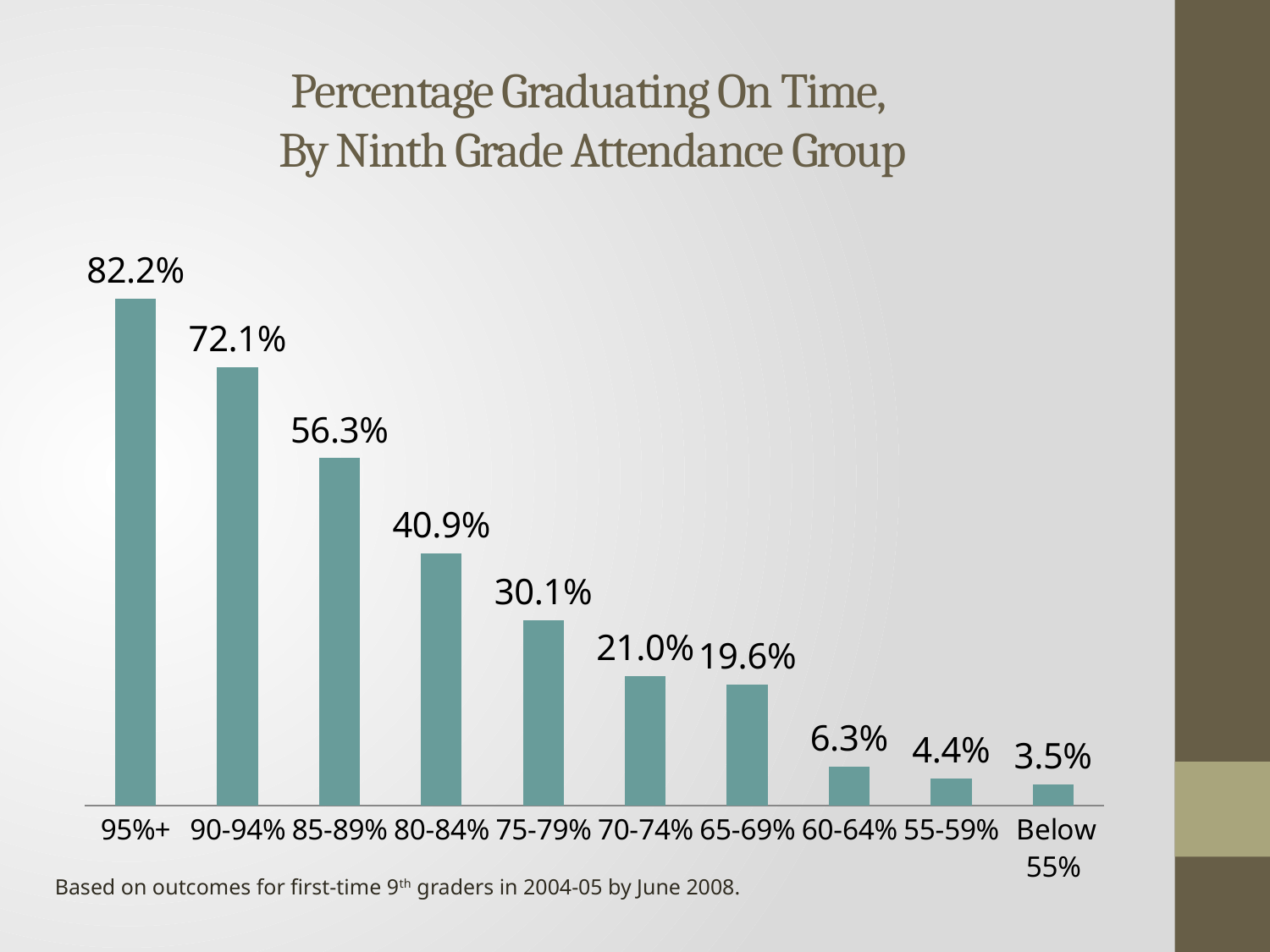
Which has a higher on-time graduation percentage, the 85-89% group or the 75-79% group? 85-89% What is the title of the chart? Percentage Graduating On Time, By Ninth Grade Attendance Group What kind of chart is shown on the slide? Bar chart How many attendance groups are shown in the chart? 10 What is the on-time graduation percentage for the 80-84% attendance group? 40.9% What value is shown for the Below 55% attendance group? 3.5% What is the difference between the values for the 70-74% and 65-69% attendance groups? 1.4% What percentage of students in the 95%+ attendance group graduated on time? 82.2% What is the difference between the on-time graduation percentages of the 95%+ and 90-94% attendance groups? 10.1% Do the values rise or fall moving from left to right across the attendance groups? Fall Which attendance group has the highest percentage graduating on time? 95%+ Which attendance group has the lowest percentage graduating on time? Below 55%